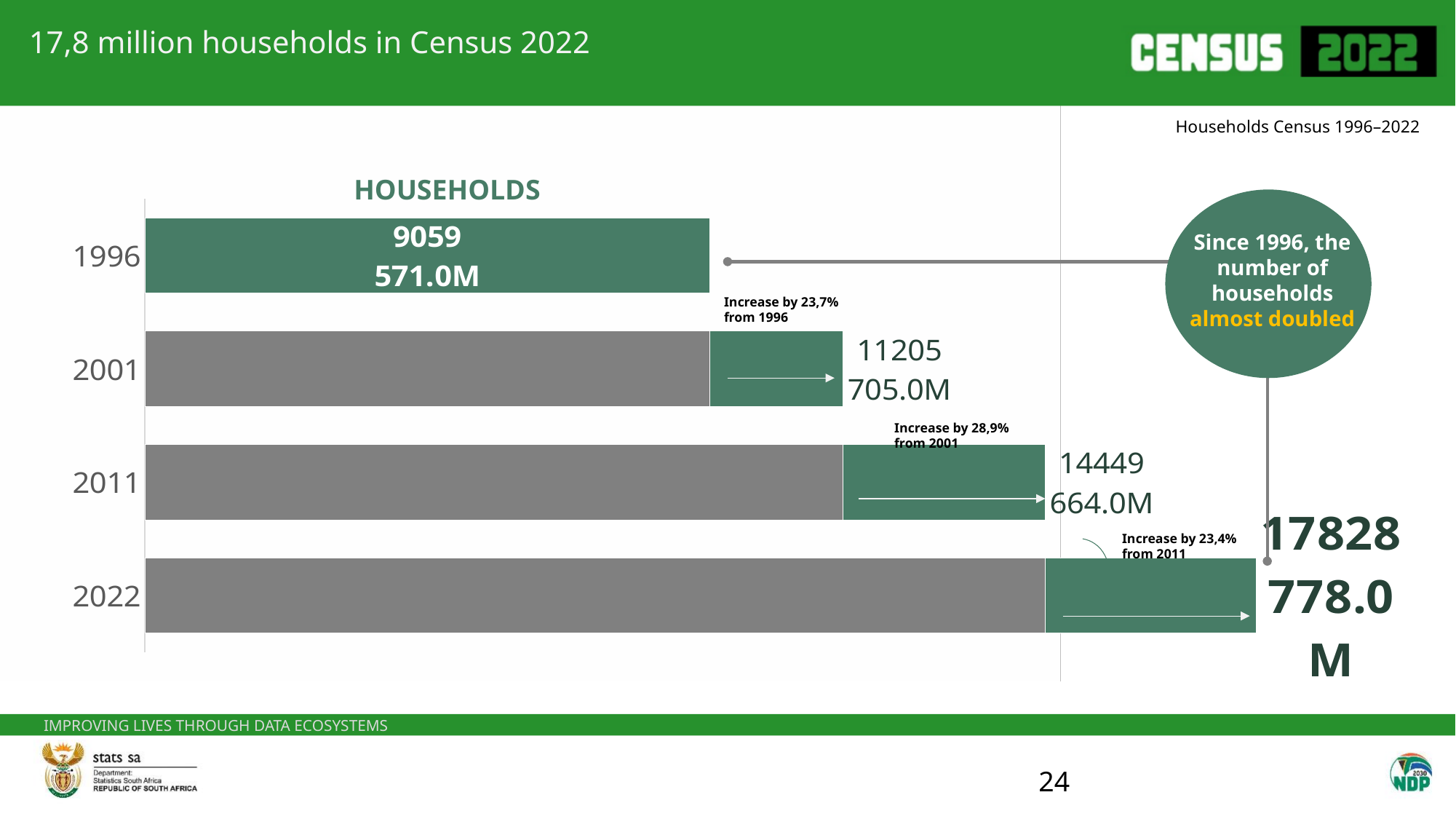
Which is larger, the number of households in 2001 or in 2011? 2011 What value is labelled on the bar for 2001? 11205 705.0M What kind of chart is shown on the slide? bar chart How many census years are shown in the chart? 4 By what percentage did households increase from 2001 to 2011, according to the chart annotation? 28,9% What value is labelled on the bar for 2011? 14449 664.0M What value is labelled on the bar for 2022? 17828 778.0M Do the number of households rise or fall from 1996 to 2022? rise What value is labelled on the bar for 1996? 9059 571.0M Which census year has the highest number of households? 2022 What is the title of the chart? HOUSEHOLDS Which census year has the lowest number of households? 1996